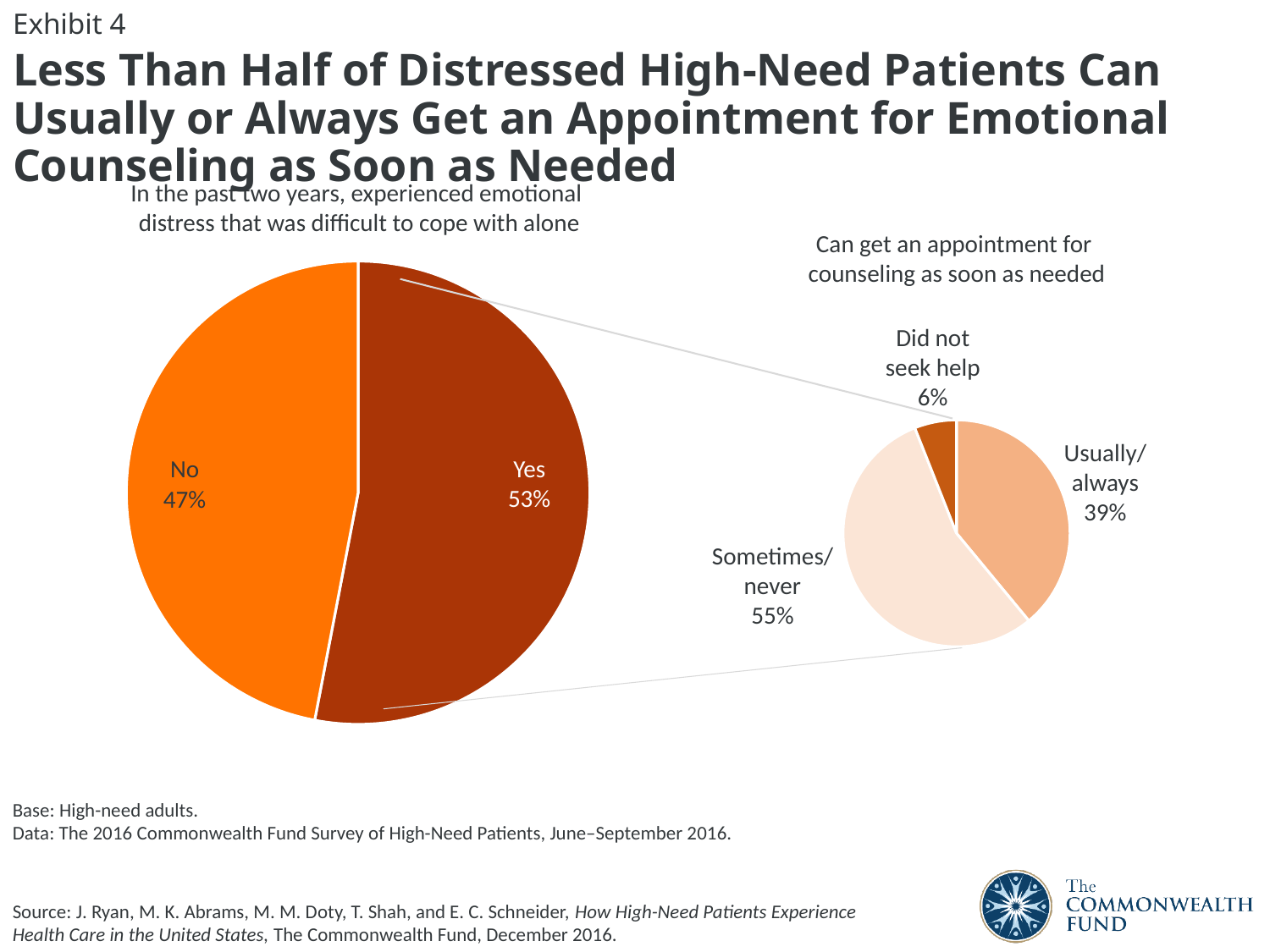
In the left pie chart (experienced emotional distress), what is the difference between the Yes and No shares? 6% How many slices does the right pie chart (can get an appointment for counseling as soon as needed) have? 3 In the right pie chart (can get an appointment for counseling as soon as needed), what is the share for Did not seek help? 6% In the left pie chart (experienced emotional distress), what percentage answered Yes? 53% In the right pie chart (can get an appointment for counseling as soon as needed), what is the share for Sometimes/never? 55% In the right pie chart (can get an appointment for counseling as soon as needed), which category has the smallest share? Did not seek help In the left pie chart (experienced emotional distress), which is larger, Yes or No? Yes In the left pie chart (experienced emotional distress), what percentage answered No? 47% What type of chart is used on the left of the slide? Pie chart In the right pie chart (can get an appointment for counseling as soon as needed), what is the share for Usually/always? 39% In the right pie chart (can get an appointment for counseling as soon as needed), what is the difference between Sometimes/never and Usually/always? 16% In the right pie chart (can get an appointment for counseling as soon as needed), which category has the largest share? Sometimes/never